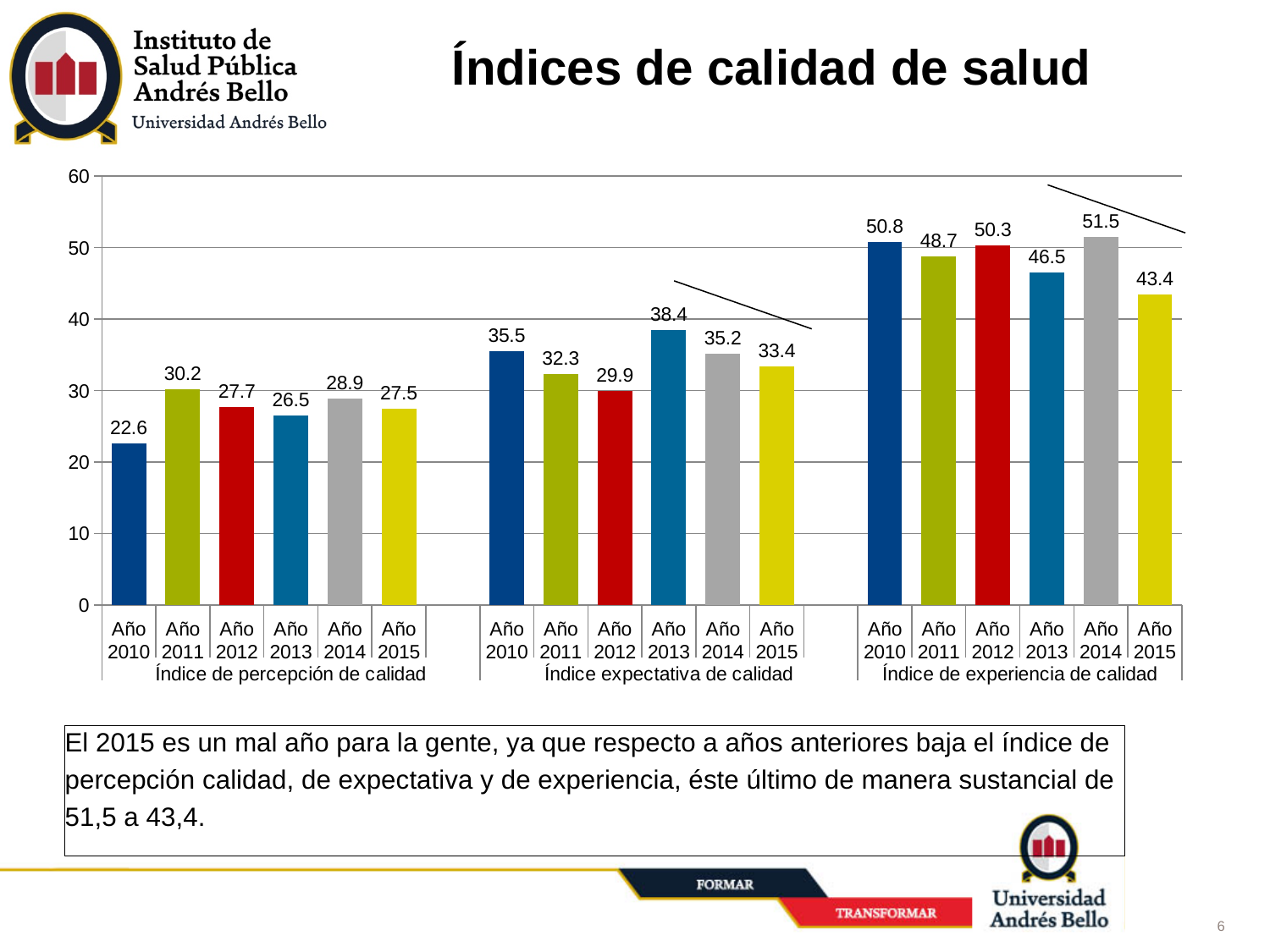
What is the value for Año 2013 in the Índice expectativa de calidad group? 38.4 Is the value for Año 2012 in the Índice de experiencia de calidad group greater or less than 40? greater How many index groups are shown on the x axis? 3 Which year has the lowest value in the Índice de percepción de calidad group? Año 2010 What is the difference between the Año 2014 and Año 2015 values in the Índice de experiencia de calidad group? 8.1 What is the title of the slide containing the chart? Índices de calidad de salud What kind of chart is shown on the slide? Bar chart What is the value for Año 2010 in the Índice de percepción de calidad group? 22.6 What is the value for Año 2015 in the Índice de experiencia de calidad group? 43.4 Which year has the highest value in the Índice de experiencia de calidad group? Año 2014 Which is larger: the Año 2011 value for Índice de percepción de calidad or the Año 2011 value for Índice expectativa de calidad? Índice expectativa de calidad How many bars are plotted in the chart in total? 18